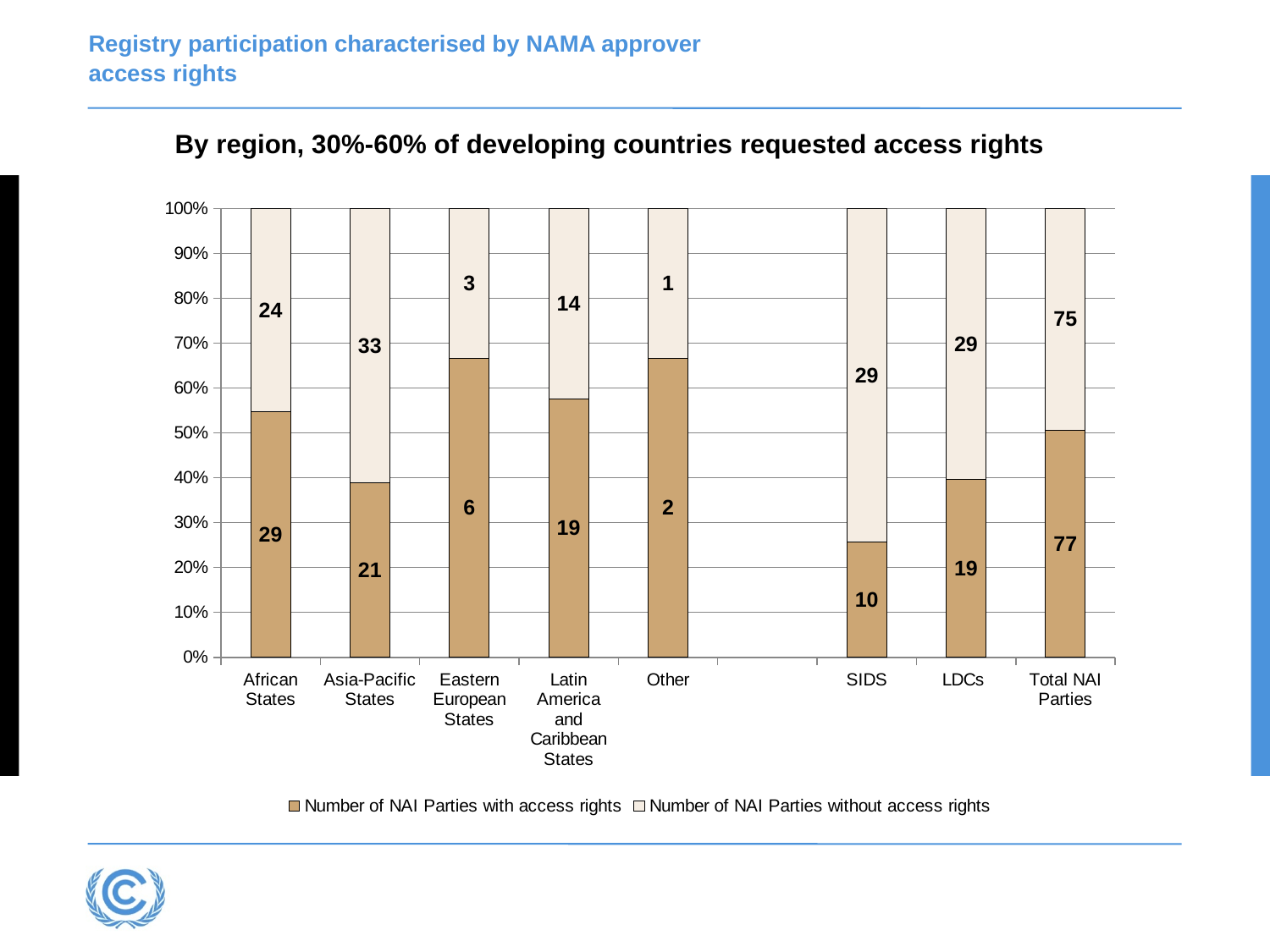
What is the difference between the number of NAI Parties with access rights and without access rights for Latin America and Caribbean States? 5 Which has more NAI Parties with access rights, Asia-Pacific States or LDCs? Asia-Pacific States Which category has the lowest number of NAI Parties with access rights? Other What is the number of NAI Parties without access rights for Asia-Pacific States? 33 What is the total number of NAI Parties (with and without access rights) for Eastern European States? 9 How many series does the legend list? 2 How many NAI Parties with access rights are shown for SIDS? 10 Which category has the highest number of NAI Parties without access rights? Total NAI Parties How many categories are shown on the x axis? 8 Is the share of NAI Parties with access rights for African States greater or less than 50%? greater Is the share of NAI Parties with access rights for SIDS greater or less than 30%? less How many NAI Parties with access rights are shown for African States? 29